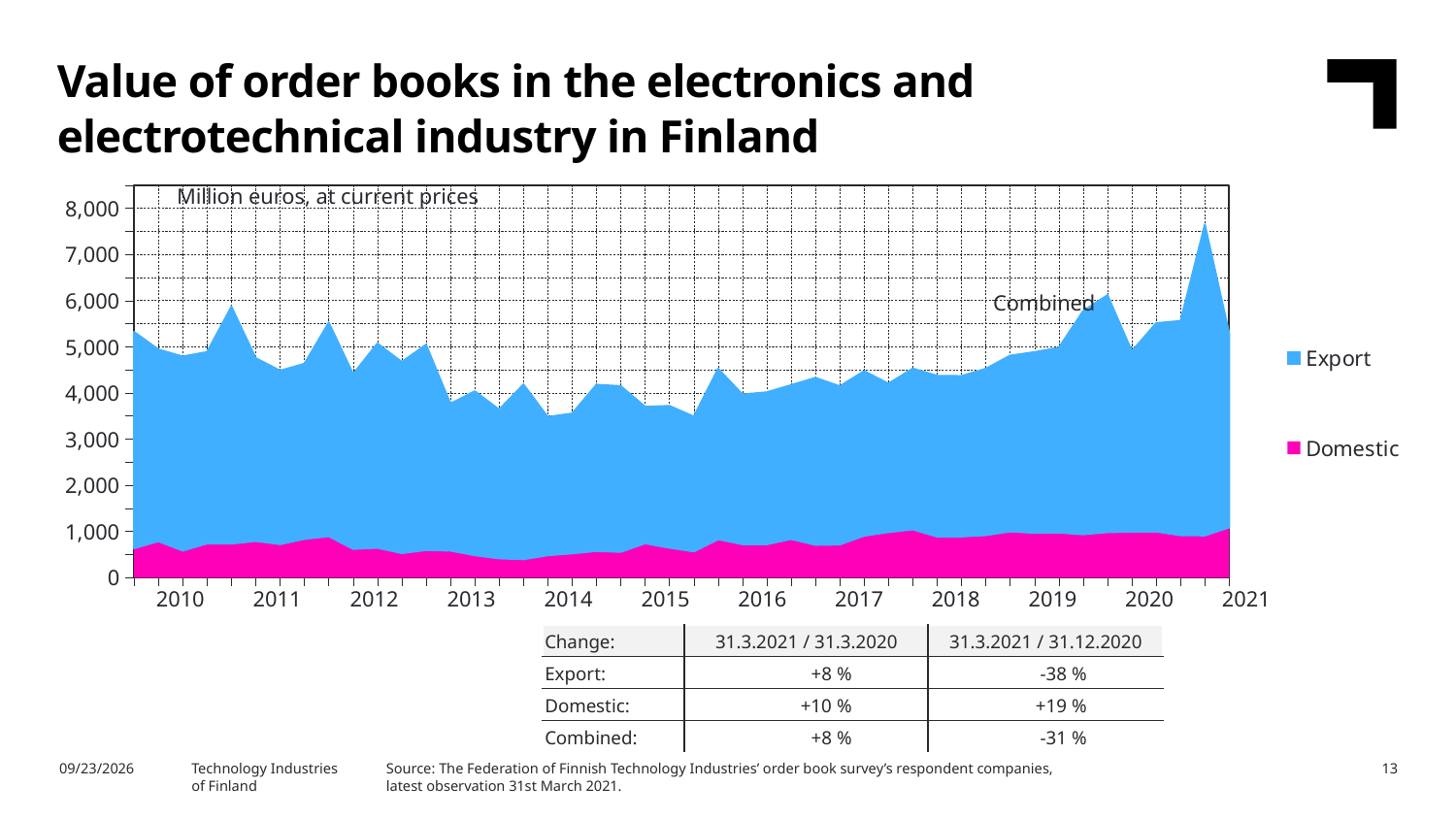
Which two series are listed in the chart legend? Export and Domestic What unit is stated for the values on the chart? Million euros, at current prices What is the highest value shown on the vertical axis? 8,000 According to the change table, what is the Domestic change for 31.3.2021 / 31.3.2020? +10 % What kind of chart is shown on the slide? Area chart Is the Domestic value in 2014 greater or less than 1,000? less How many series does the chart legend list? 2 Which series accounts for the larger part of the combined order book value throughout the chart, Export or Domestic? Export According to the change table, what is the Export change for 31.3.2021 / 31.12.2020? -38 % Is the combined value in mid-2015 greater or less than 4,000? less Is the peak combined value reached in late 2020 greater or less than 7,000? greater